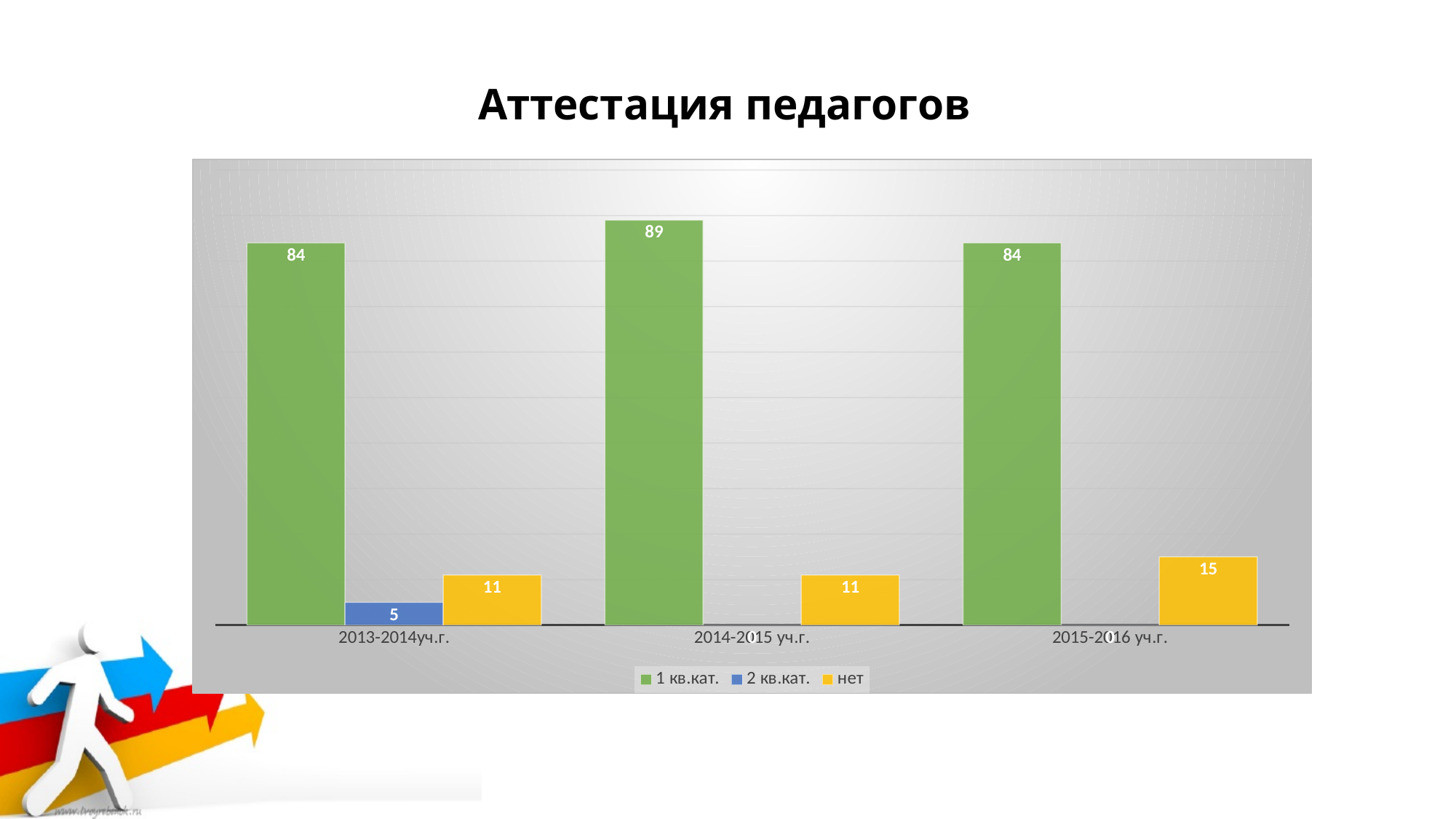
What is the value for "1 кв.кат." in 2014-2015 уч.г.? 89 How many year categories are shown on the x axis? 3 What is the value for "1 кв.кат." in 2013-2014уч.г.? 84 What is the difference between the "нет" value in 2015-2016 уч.г. and in 2014-2015 уч.г.? 4 What is the difference between the "1 кв.кат." value in 2014-2015 уч.г. and in 2015-2016 уч.г.? 5 How many series does the legend list? 3 What is the value for "2 кв.кат." in 2013-2014уч.г.? 5 What kind of chart is shown on the slide? Bar chart What is the value for "нет" in 2015-2016 уч.г.? 15 In which year is the "нет" value highest? 2015-2016 уч.г. Which is larger: the "нет" value in 2013-2014уч.г. or the "2 кв.кат." value in 2013-2014уч.г.? нет In which year is the "1 кв.кат." value highest? 2014-2015 уч.г.